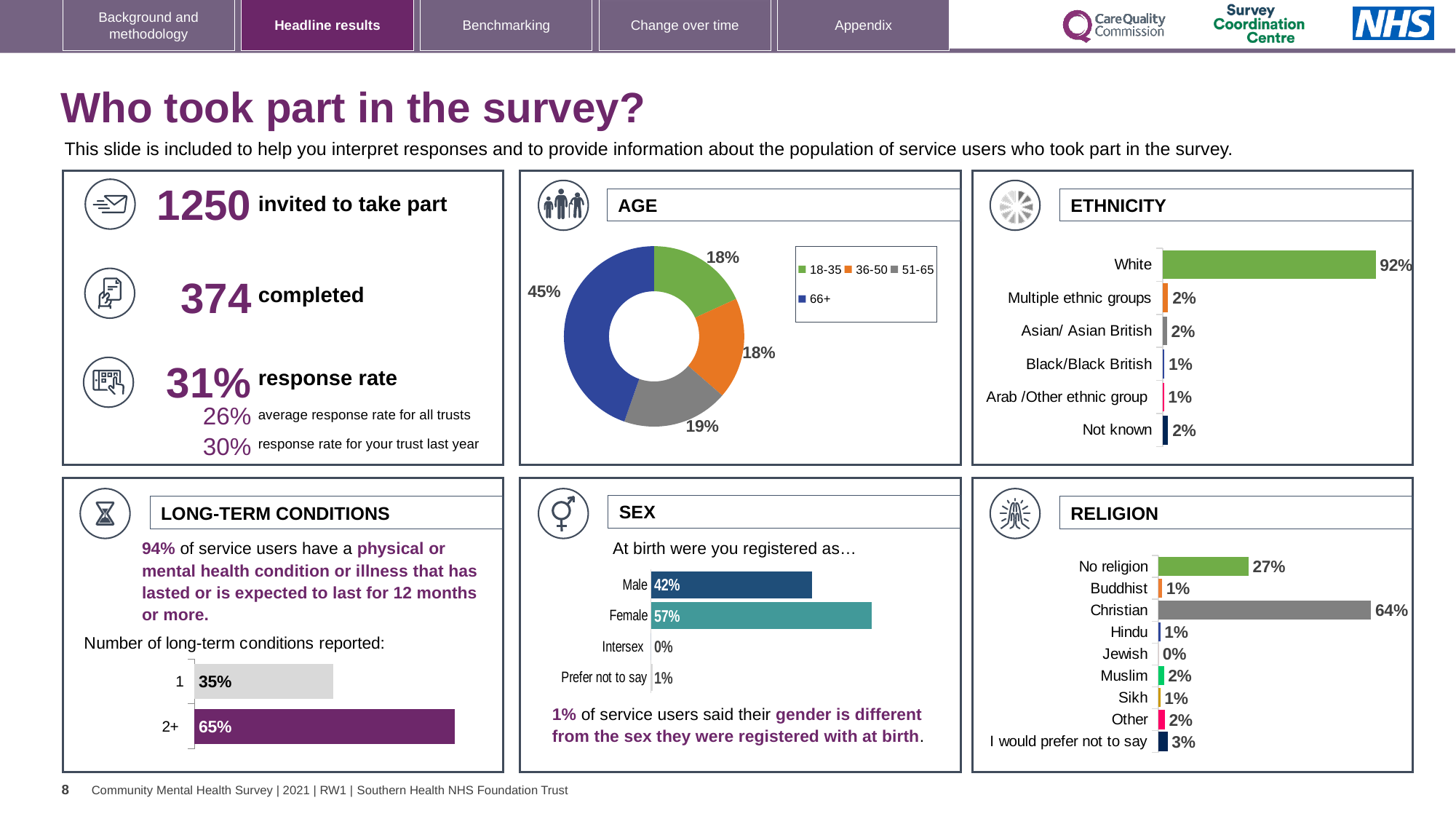
In the ETHNICITY chart, what is the value for White? 92% In the RELIGION chart, what is the value for No religion? 27% In the SEX chart, which is larger, Male or Female? Female In the ETHNICITY chart, what is the difference between White and Multiple ethnic groups? 90% What kind of chart is the AGE chart? Donut chart In the AGE chart, how many entries does the legend list? 4 In the LONG-TERM CONDITIONS chart, what is the value for 2+ conditions? 65% In the AGE chart, what share of respondents were aged 66+? 45% In the RELIGION chart, which category has the highest value? Christian In the ETHNICITY chart, how many ethnic categories are shown? 6 In the SEX chart, what is the difference between Female and Male? 15% In the RELIGION chart, how many categories are shown? 9